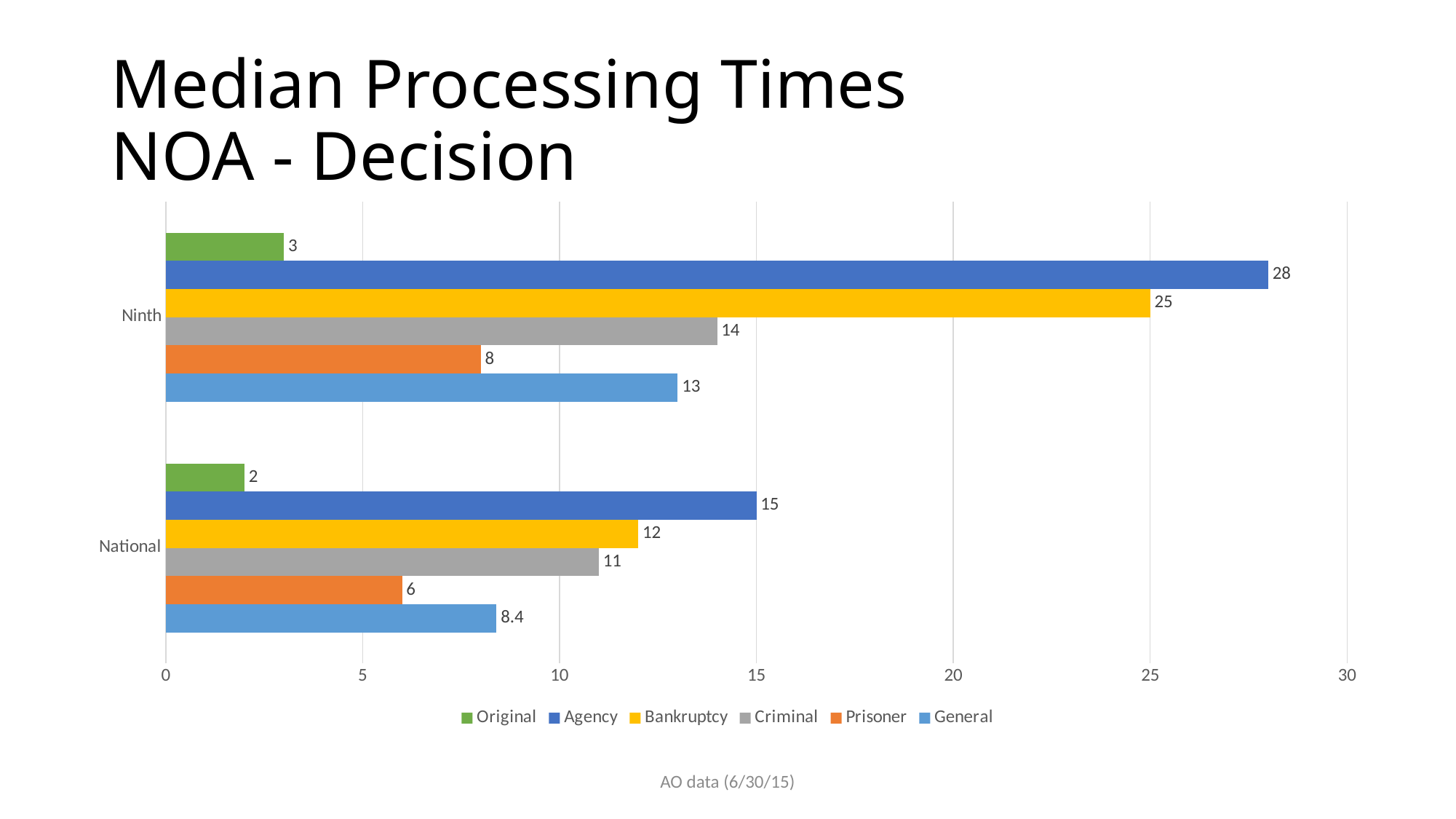
Which series has the lowest value in the National category? Original Which is larger, the Bankruptcy value for Ninth or the Bankruptcy value for National? Ninth What is the difference between the Agency values for Ninth and National? 13 Which series has the highest value in the Ninth category? Agency What is the value for Criminal in the Ninth category? 14 What is the title of the slide? Median Processing Times NOA - Decision How many series does the legend list? 6 What kind of chart is shown on the slide? Bar chart Is the value for Prisoner in the Ninth category greater or less than 10? less What is the value for Agency in the Ninth category? 28 How many categories are shown on the vertical axis? 2 What is the value for General in the National category? 8.4